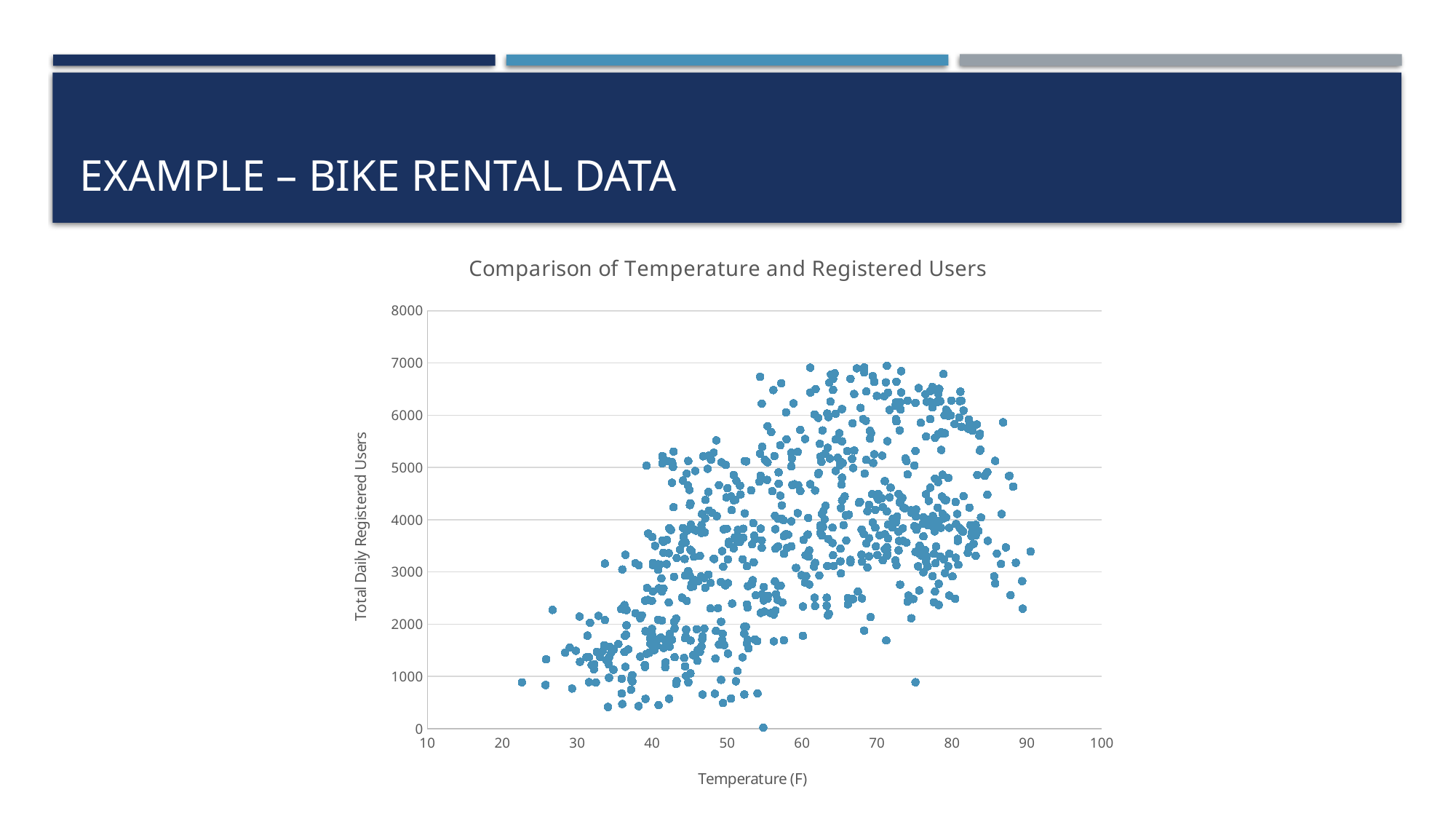
Is the lowest temperature plotted on the chart greater or less than 20? greater How many data series are plotted on the chart? 1 As temperature increases along the x axis, do the registered user values generally rise or fall? Rise What is the label of the x axis of the chart? Temperature (F) Is the highest registered-users value plotted on the chart greater or less than 8000? less What is the title of the chart? Comparison of Temperature and Registered Users What kind of chart is shown on the slide? Scatter plot Is the lowest registered-users value plotted on the chart greater or less than 500? less